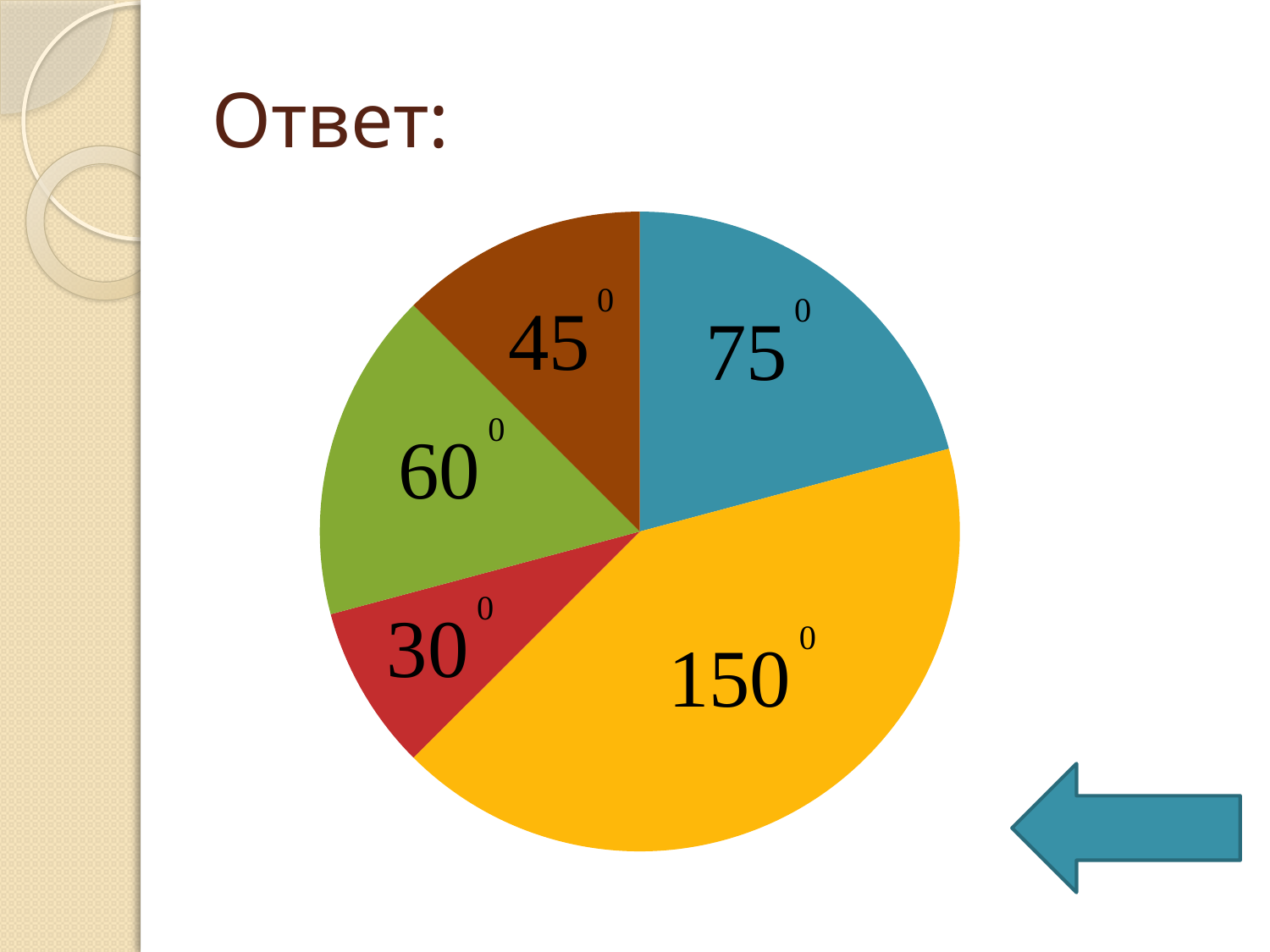
Which slice of the pie chart has the largest value? the yellow slice (150°) What value is labelled on the yellow slice of the pie chart? 150° What is the difference between the values of the yellow slice and the blue slice? 75° Which is larger, the value of the green slice or the value of the brown slice? the green slice (60°) What value is labelled on the green slice of the pie chart? 60° What value is labelled on the blue slice of the pie chart? 75° What value is labelled on the brown slice of the pie chart? 45° What share of the whole pie does the brown slice (45°) represent? 12.5% Which slice of the pie chart has the smallest value? the red slice (30°) What type of chart is shown on the slide? pie chart How many slices does the pie chart have? 5 What value is labelled on the red slice of the pie chart? 30°